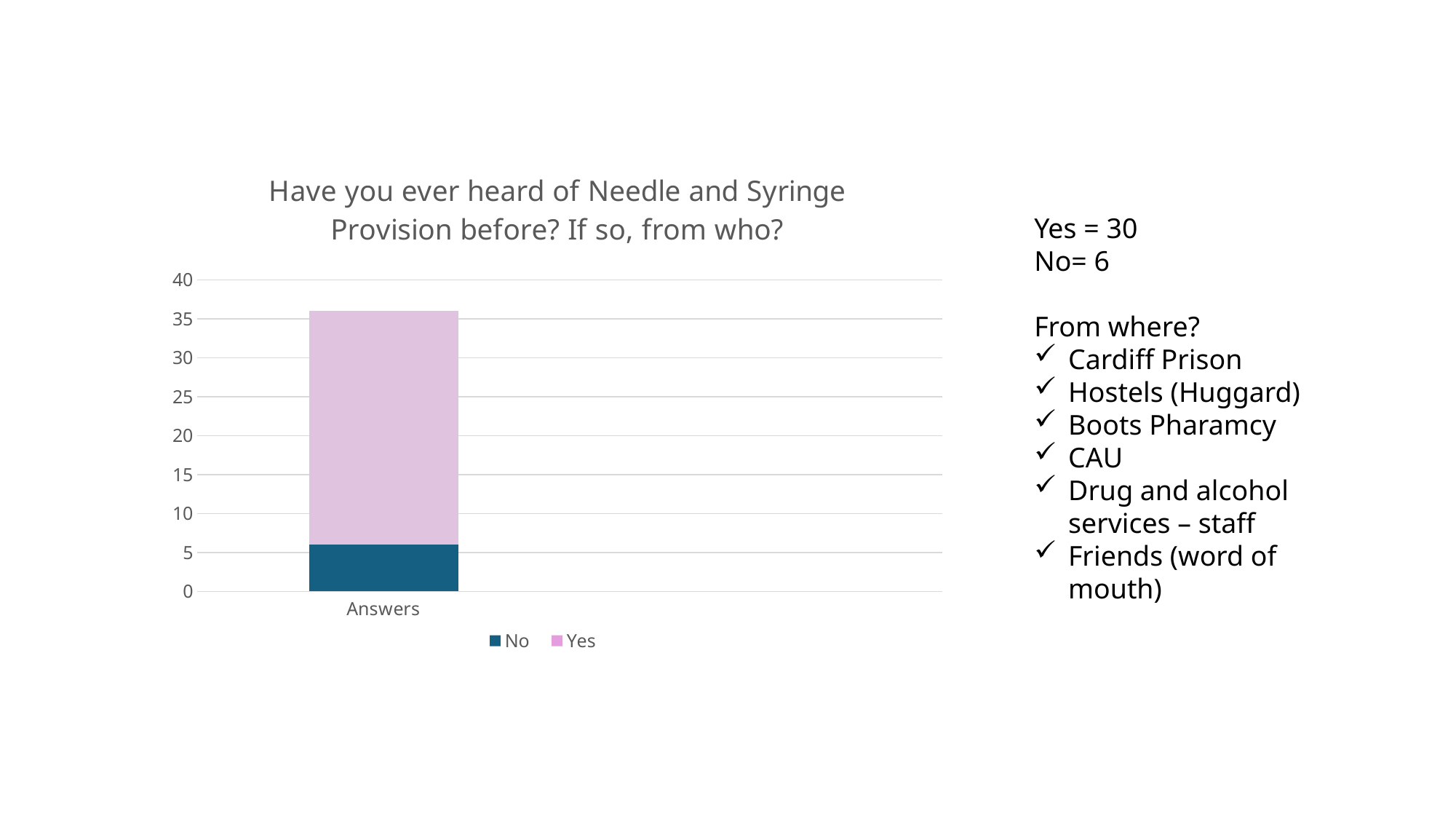
What are the two series named in the chart legend? No and Yes What is the title of the chart? Have you ever heard of Needle and Syringe Provision before? If so, from who? What is the difference between the Yes and No values? 24 How many series does the chart legend list? 2 Is the total height of the Answers bar greater or less than 30? greater What is the label of the category on the x axis? Answers Which series has the larger value, Yes or No? Yes What is the value for Yes in the chart? 30 What kind of chart is shown on the slide? bar chart What is the value for No in the chart? 6 How many categories are shown on the x axis of the chart? 1 What is the total of the stacked bar for Answers? 36